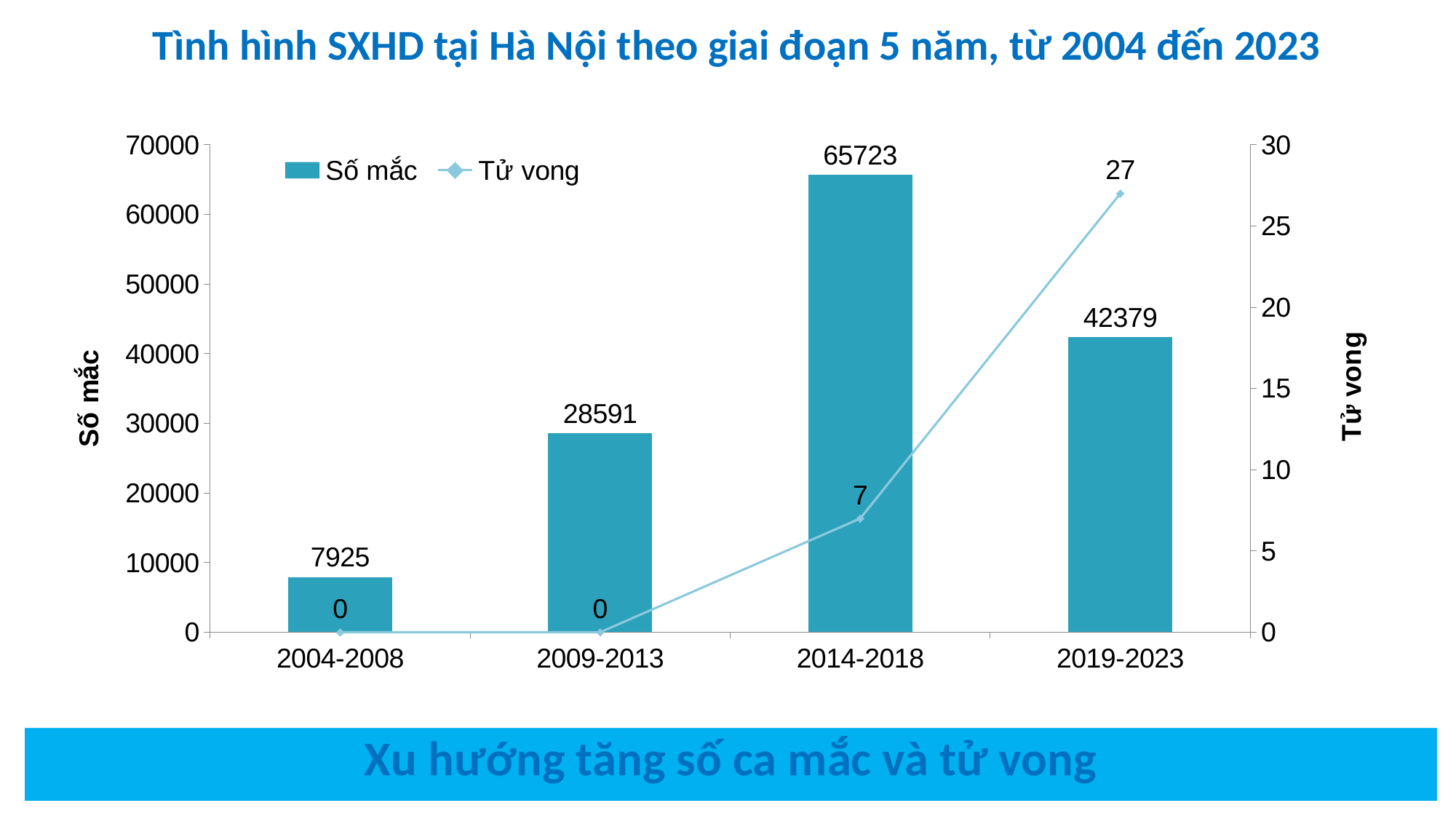
What is the difference in Tử vong between 2019-2023 and 2014-2018? 20 Which is larger, Số mắc for 2009-2013 or for 2019-2023? 2019-2023 What is the value of Tử vong for 2019-2023? 27 Is the Số mắc value for 2009-2013 greater or less than 30000? less What is the title of the chart? Tình hình SXHD tại Hà Nội theo giai đoạn 5 năm, từ 2004 đến 2023 How many periods are shown on the x axis? 4 How many series does the legend list? 2 What is the difference in Số mắc between 2014-2018 and 2019-2023? 23344 What is the value of Số mắc for 2014-2018? 65723 Which period has the highest Số mắc? 2014-2018 Which period has the lowest Số mắc? 2004-2008 What is the value of Số mắc for 2004-2008? 7925